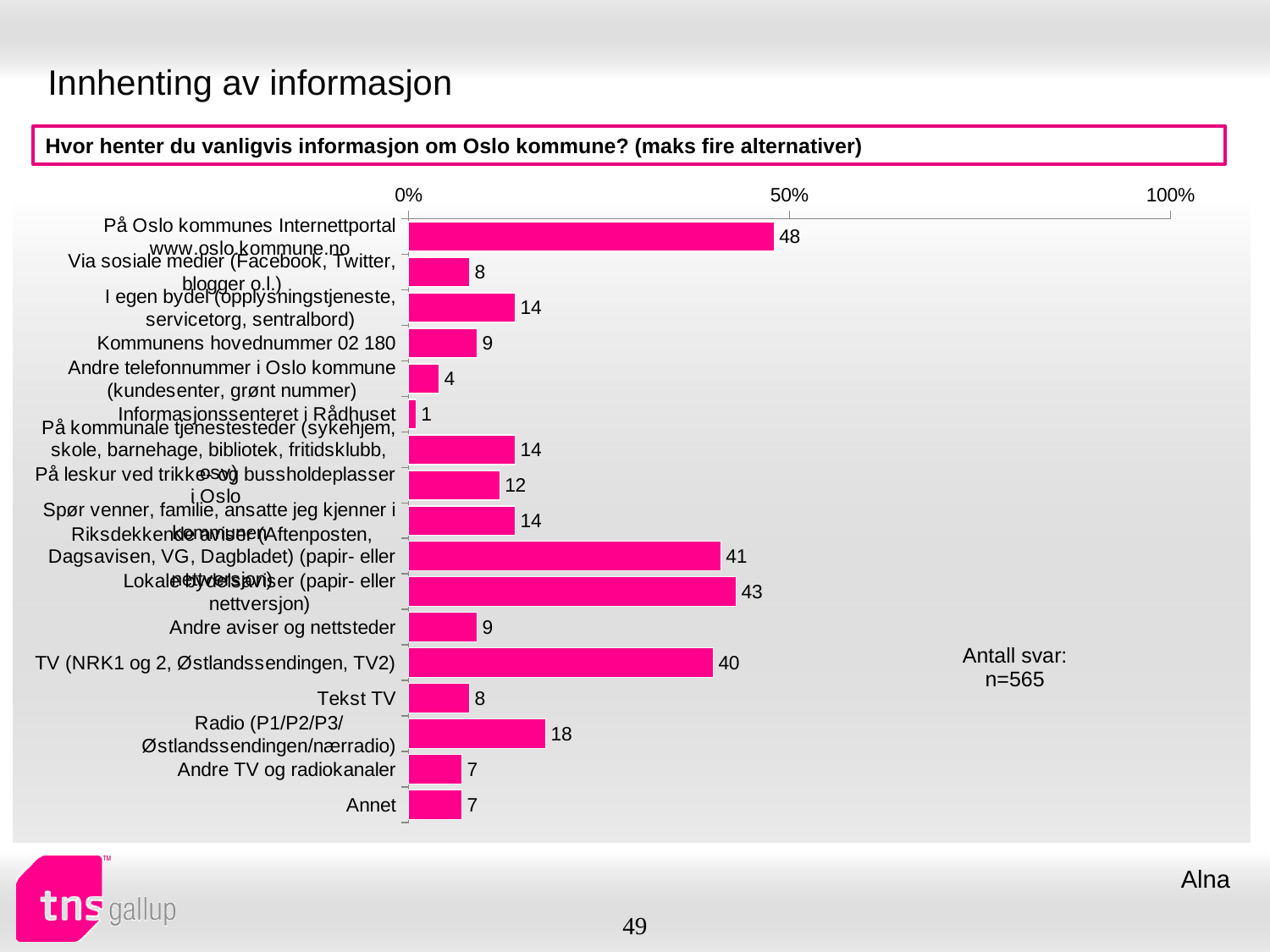
What is the difference between the value for "På Oslo kommunes Internettportal www.oslo.kommune.no" and the value for "Lokale bydelsaviser (papir- eller nettversjon)"? 5 What kind of chart is shown on the slide? bar chart What is the value for "Informasjonssenteret i Rådhuset"? 1 Is the value for "På Oslo kommunes Internettportal www.oslo.kommune.no" greater or less than 50%? less Which category has the highest value? På Oslo kommunes Internettportal www.oslo.kommune.no What is the value for "Tekst TV"? 8 What is the number of respondents (n) stated on the slide? n=565 What is the value for "Radio (P1/P2/P3/Østlandssendingen/nærradio)"? 18 Which is larger: the value for "Lokale bydelsaviser (papir- eller nettversjon)" or the value for "TV (NRK1 og 2, Østlandssendingen, TV2)"? Lokale bydelsaviser (papir- eller nettversjon) Which category has the lowest value? Informasjonssenteret i Rådhuset How many categories are shown in the chart? 17 What is the value for "Kommunens hovednummer 02 180"? 9